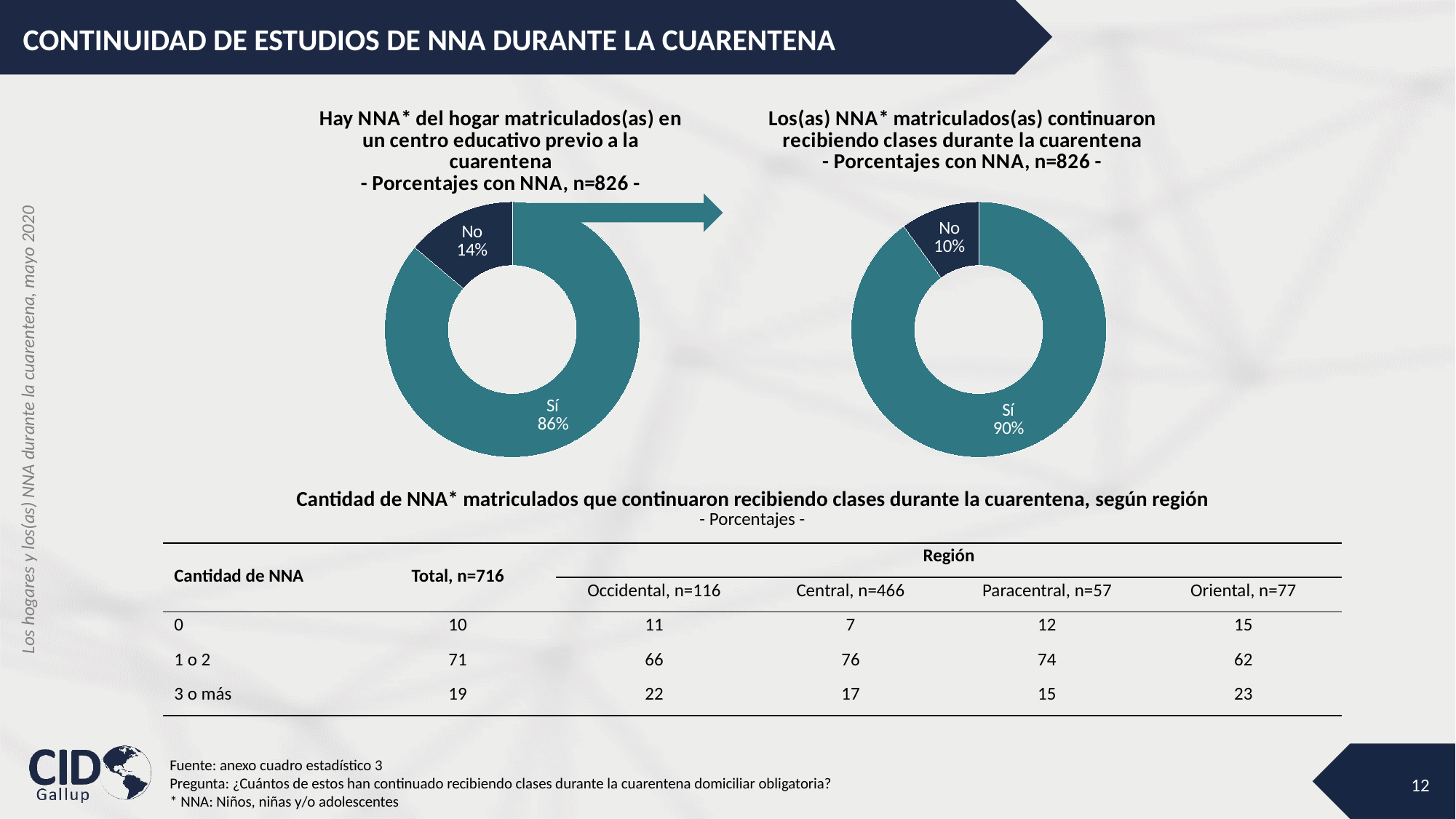
In the left chart (NNA matriculados previo a la cuarentena), what is the difference in percentage points between Sí and No? 72 Which is larger: the Sí share in the left chart or the Sí share in the right chart? The Sí share in the right chart (90%) In the right chart (continuaron recibiendo clases durante la cuarentena), what percentage answered No? 10% What is the sample size (n) stated in the title of the right chart? n=826 In the left chart (NNA matriculados previo a la cuarentena), which category has the largest share? Sí In the right chart (continuaron recibiendo clases durante la cuarentena), which category has the smallest share? No In the left chart (NNA matriculados previo a la cuarentena), what percentage answered No? 14% In the right chart (continuaron recibiendo clases durante la cuarentena), what is the difference in percentage points between Sí and No? 80 In the right chart (continuaron recibiendo clases durante la cuarentena), what percentage answered Sí? 90% What type of chart is used for the right chart (continuaron recibiendo clases durante la cuarentena)? Donut (pie) chart How many categories does the left chart (NNA matriculados previo a la cuarentena) show? 2 In the left chart (NNA matriculados previo a la cuarentena), what percentage answered Sí? 86%